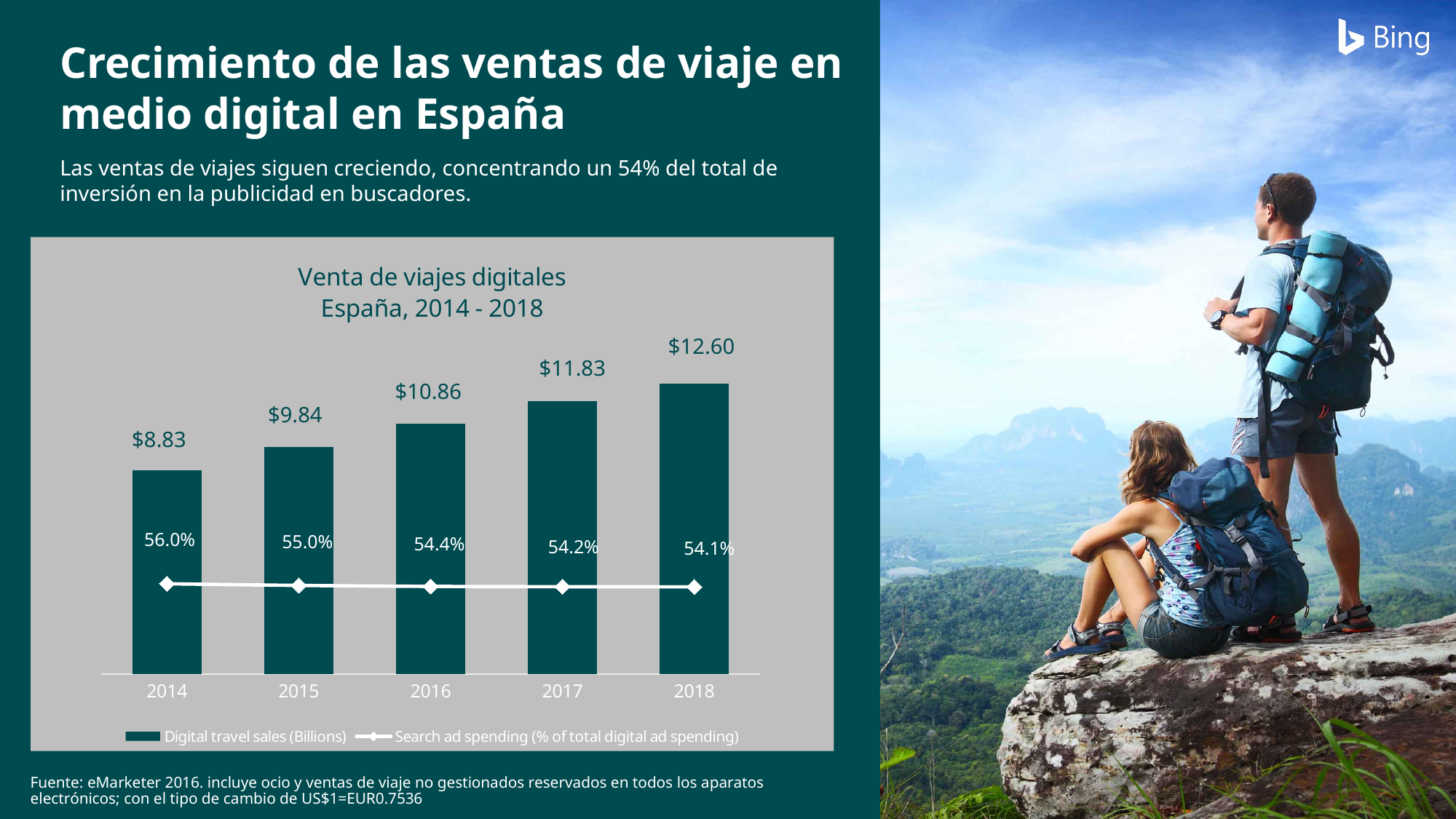
What is the difference in Digital travel sales (Billions) between 2018 and 2014? $3.77 How many years are shown on the x axis of the chart? 5 Which year has the highest Digital travel sales (Billions)? 2018 What is the value of Digital travel sales (Billions) for 2016? $10.86 Which is larger, the Digital travel sales value for 2015 or for 2017? 2017 Which year has the lowest Search ad spending (% of total digital ad spending)? 2018 What is the Search ad spending (% of total digital ad spending) value for 2014? 56.0% What is the title of the chart? Venta de viajes digitales España, 2014 - 2018 Do the Digital travel sales (Billions) values rise or fall from 2014 to 2018? Rise How many series does the chart legend list? 2 What kind of chart is used to show Digital travel sales (Billions)? Bar chart Do the Search ad spending (% of total digital ad spending) values rise or fall from 2014 to 2018? Fall